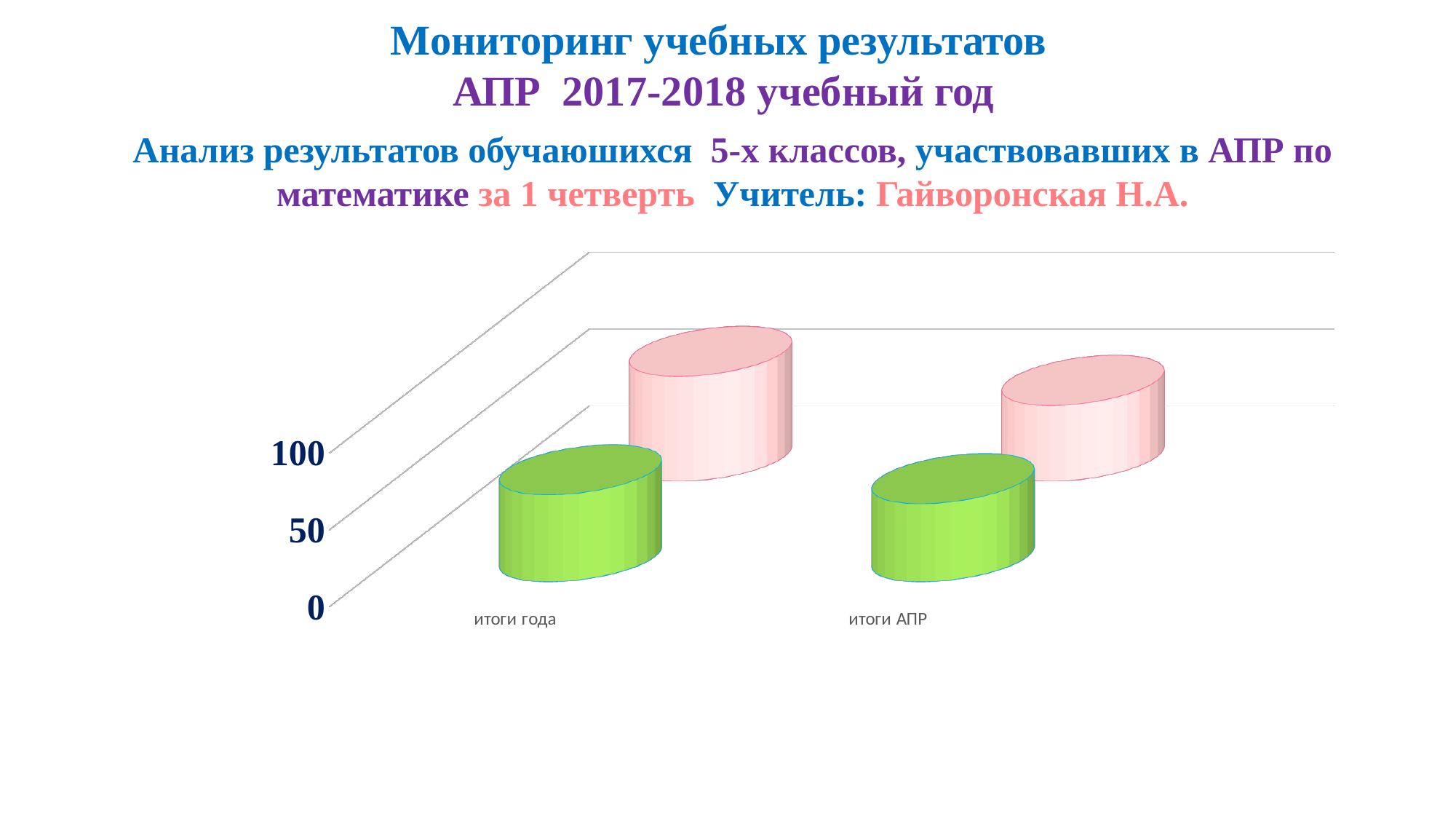
In the category 'итоги года', which bar is taller, the green one or the pink one? the pink one Is the value of the green bar for 'итоги года' greater or less than 100? less Which category has the tallest pink bar? итоги года Is the value of the pink bar for 'итоги года' greater or less than 50? greater What is the highest tick label shown on the vertical axis of the chart? 100 Does the pink series rise or fall from 'итоги года' to 'итоги АПР'? fall How many categories are shown on the x axis of the chart? 2 How many bars are plotted for each category in the chart? 2 What kind of chart is shown on the slide? bar chart What are the two category labels on the x axis of the chart? итоги года, итоги АПР